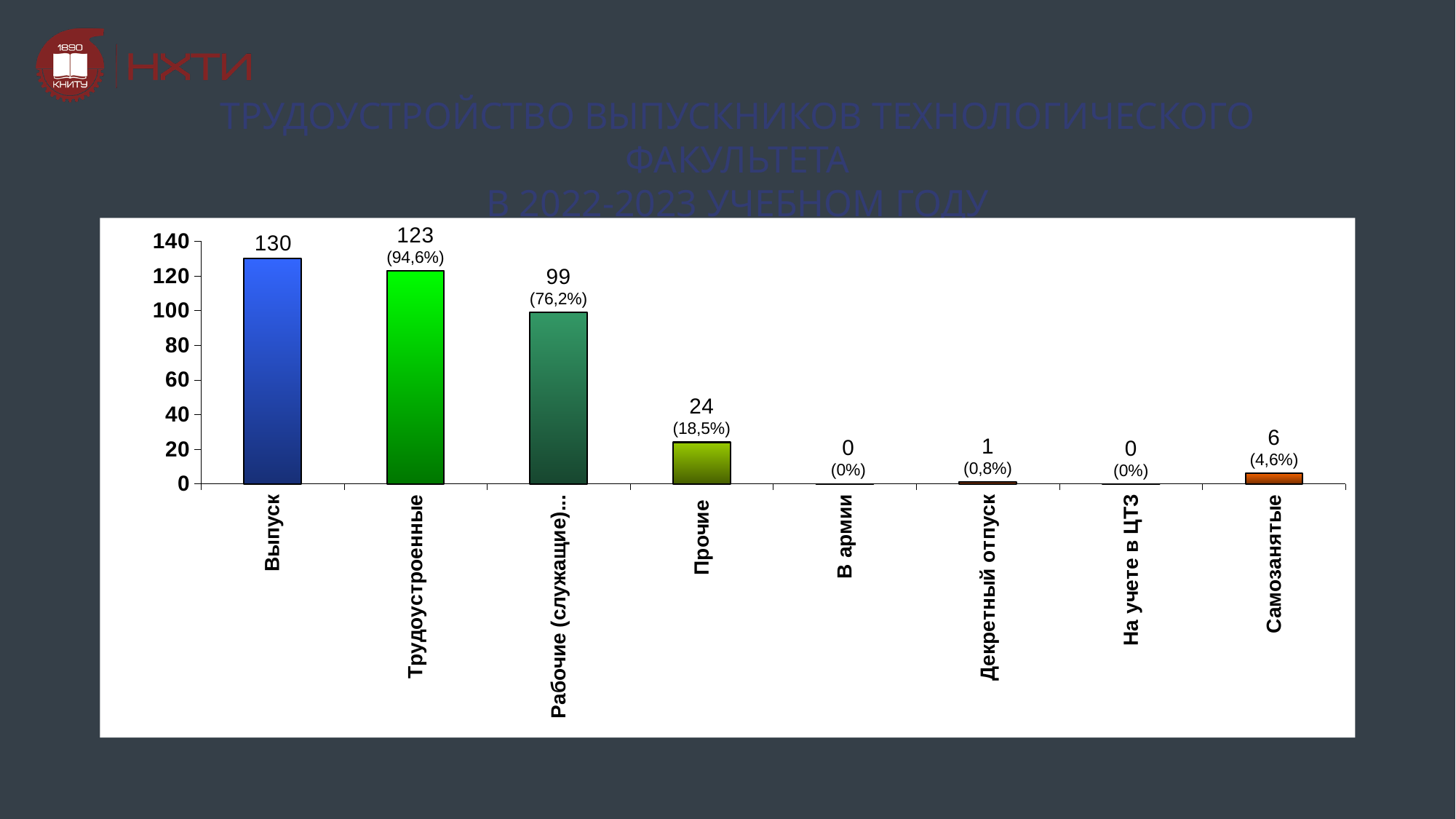
Which is larger, the value for Самозанятые or the value for Декретный отпуск? Самозанятые What percentage is shown for Прочие? 18,5% How many categories are shown on the x axis? 8 What is the value for Самозанятые? 6 What percentage is shown for Трудоустроенные? 94,6% What is the difference between the values for Выпуск and Трудоустроенные? 7 What is the value for Трудоустроенные? 123 What is the value for Выпуск? 130 What kind of chart is shown on the slide? Bar chart What is the difference between the values for Трудоустроенные and Прочие? 99 Which category has the highest value? Выпуск What is the value for Декретный отпуск? 1